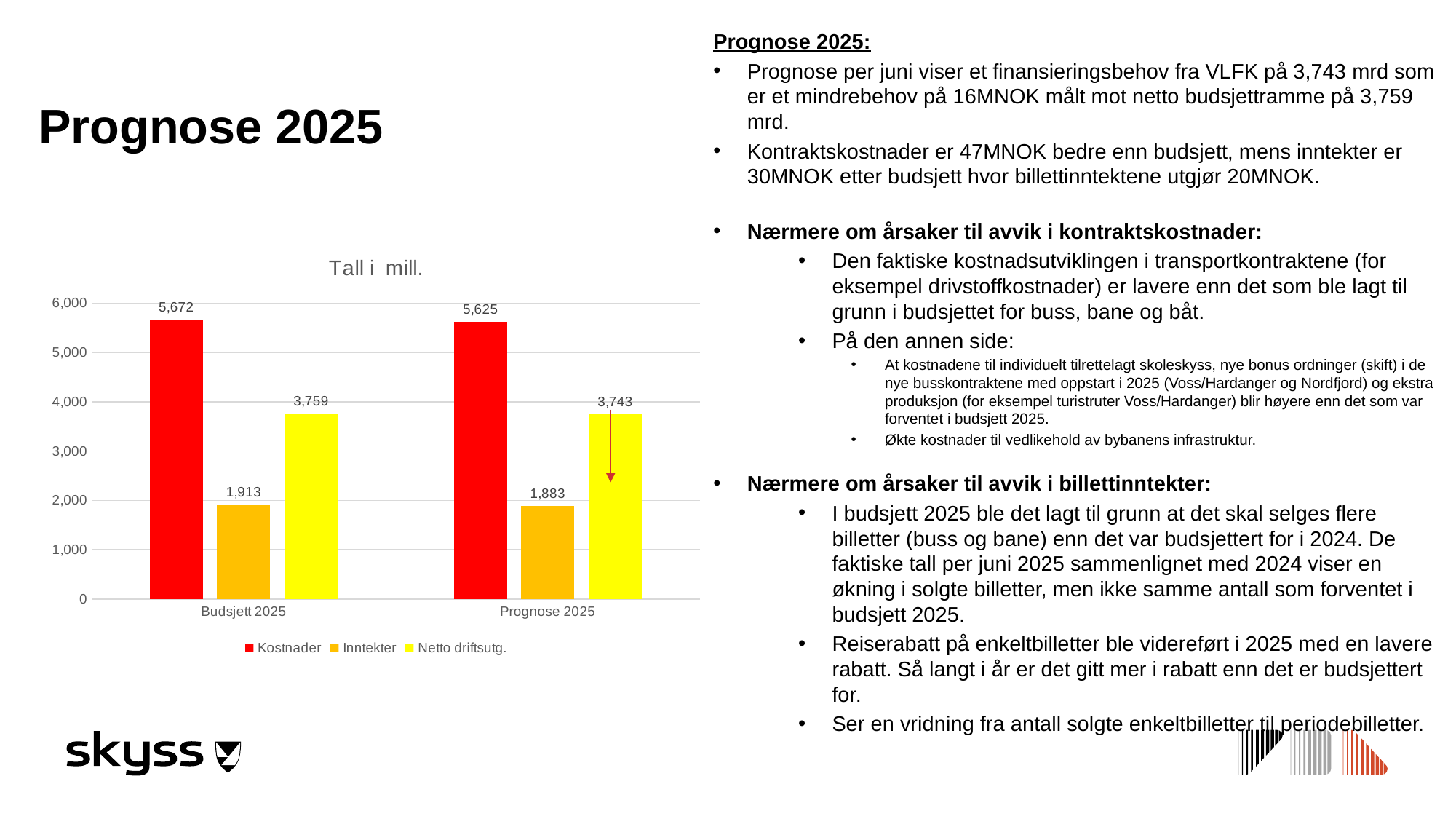
Which series has the lowest value for Budsjett 2025? Inntekter What is the value of Netto driftsutg. for Budsjett 2025? 3,759 What is the value of Kostnader for Prognose 2025? 5,625 How many series does the legend list? 3 What is the difference between Netto driftsutg. for Budsjett 2025 and for Prognose 2025? 16 Which is larger: Inntekter for Budsjett 2025 or Inntekter for Prognose 2025? Budsjett 2025 What kind of chart is shown on the slide? Bar chart What is the difference between Kostnader for Budsjett 2025 and Kostnader for Prognose 2025? 47 Which series has the highest value for Prognose 2025? Kostnader What is the value of Inntekter for Prognose 2025? 1,883 What is the title of the chart? Tall i mill. What is the value of Kostnader for Budsjett 2025? 5,672